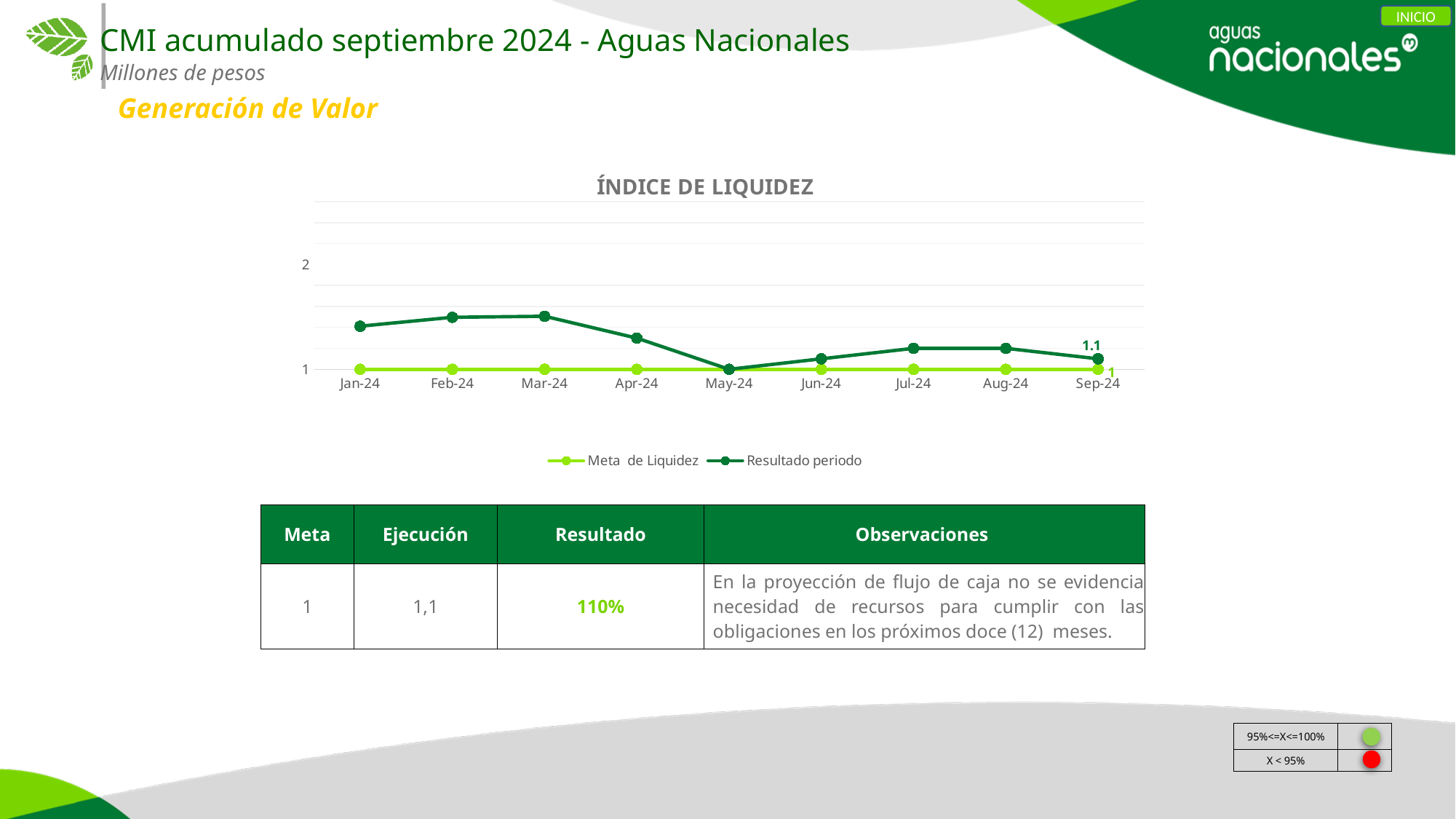
What is the value of Resultado periodo for Sep-24? 1.1 How many series does the chart legend list? 2 In which month is Resultado periodo at its lowest? May-24 What kind of chart is shown on the slide? line chart What is the title of the chart? ÍNDICE DE LIQUIDEZ What is the difference between Resultado periodo and Meta de Liquidez in Sep-24? 0.1 Does Resultado periodo rise or fall from Mar-24 to May-24? fall How many months are plotted along the x axis of the chart? 9 Which is higher for Resultado periodo: Jan-24 or Apr-24? Jan-24 Is the value of Resultado periodo for Mar-24 greater or less than 2? less Is the value of Resultado periodo for Jan-24 greater or less than 1? greater What is the value of Meta de Liquidez for Sep-24? 1